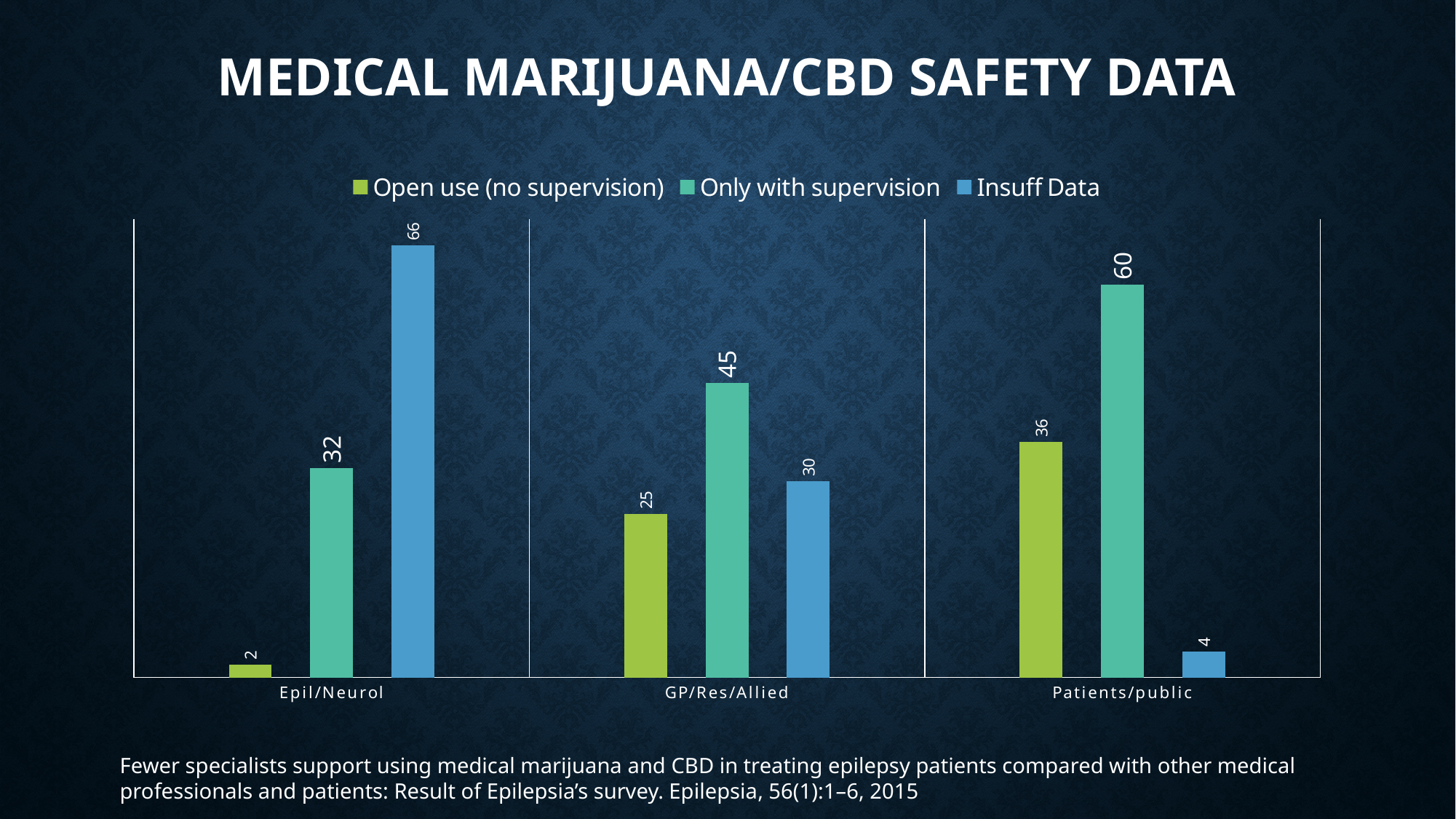
How many categories are shown on the x axis? 3 What is the value for Only with supervision in the Patients/public category? 60 What is the value for Insuff Data in the Epil/Neurol category? 66 What is the title of the slide? Medical Marijuana/CBD Safety Data What kind of chart is shown on the slide? Bar chart What is the difference between Only with supervision and Open use (no supervision) in the Patients/public category? 24 Which category has the lowest value for Insuff Data? Patients/public Which category has the highest value for Open use (no supervision)? Patients/public Which is larger in the GP/Res/Allied category: Only with supervision or Insuff Data? Only with supervision How many series does the legend list? 3 What is the value for Open use (no supervision) in the GP/Res/Allied category? 25 Does the Only with supervision series rise or fall from Epil/Neurol to Patients/public? Rise